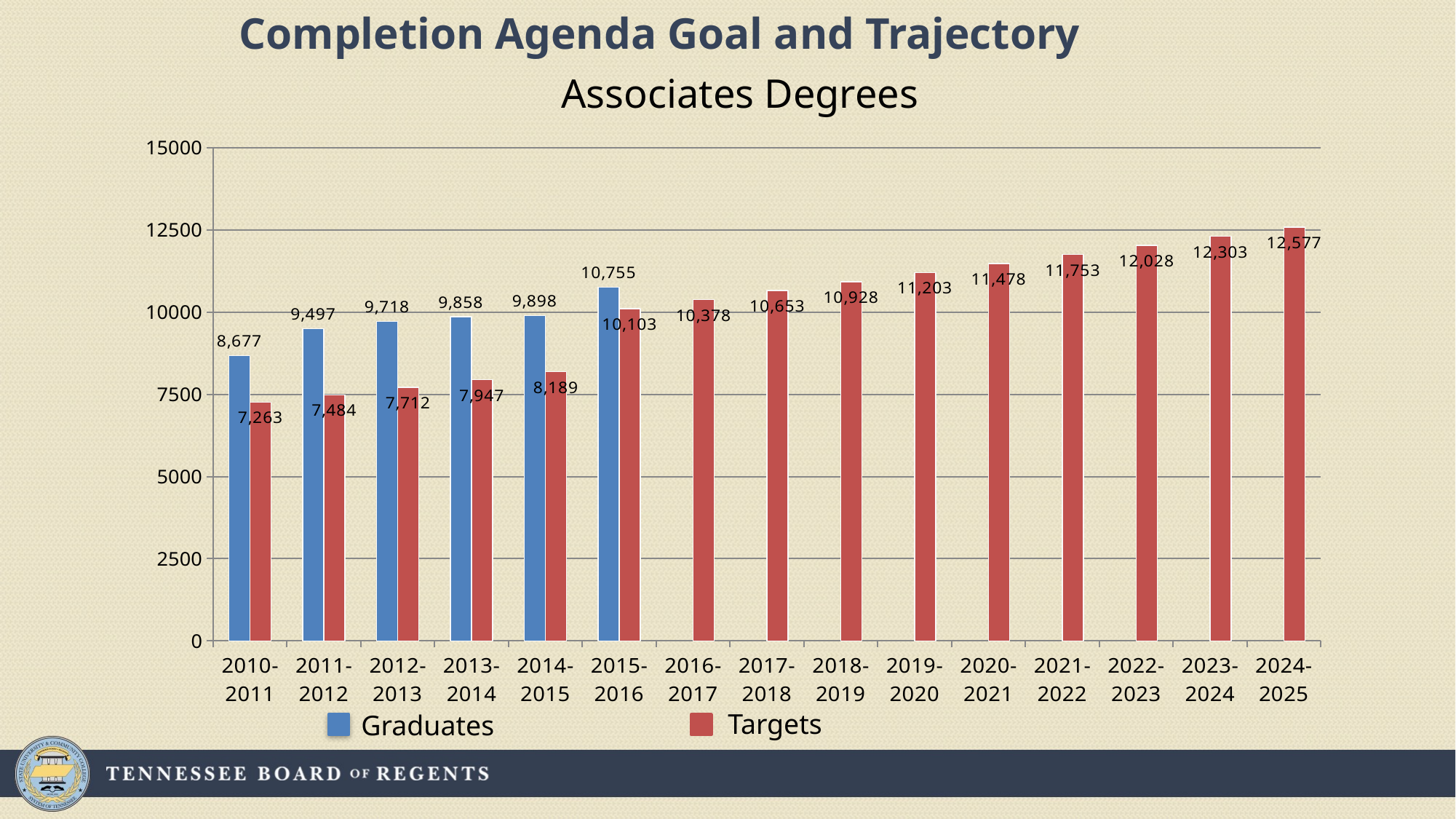
What is the Targets value for 2015-2016? 10,103 How many series does the legend list? 2 Is the Targets value for 2020-2021 greater or less than 10000? greater How many year categories are shown on the x axis? 15 What is the Graduates value for 2010-2011? 8,677 What is the difference between Graduates and Targets in 2014-2015? 1,709 Which is larger in 2012-2013, Graduates or Targets? Graduates What is the Targets value for 2024-2025? 12,577 Which year has the highest Graduates value? 2015-2016 Which year has the lowest Targets value? 2010-2011 What kind of chart is shown? Bar chart Do the Targets values rise or fall from 2010-2011 to 2024-2025? Rise